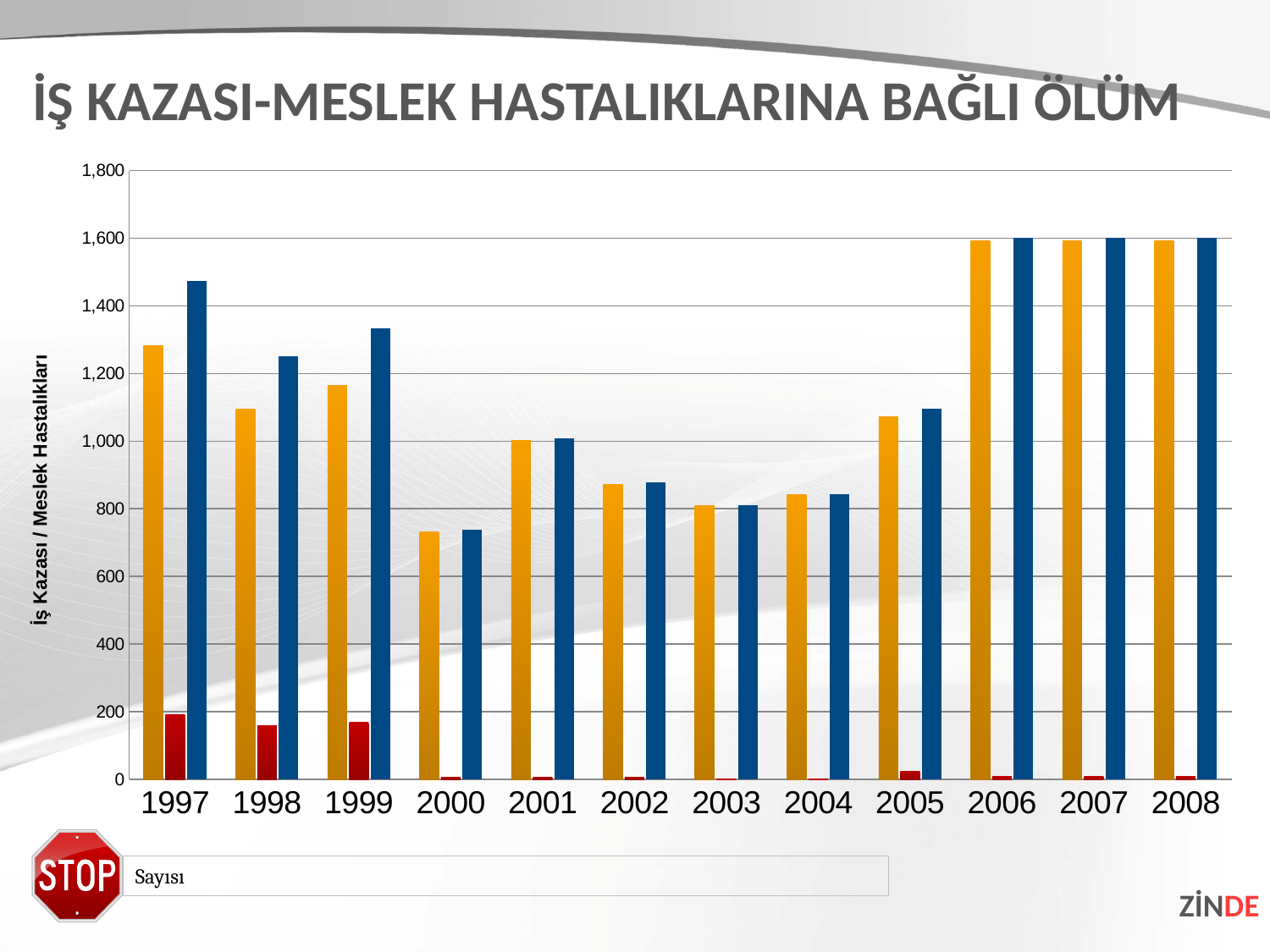
Which year has the larger blue bar, 1997 or 1998? 1997 Is the blue bar for 1997 greater or less than 1,400? greater What kind of chart is shown on the slide? bar chart What is the title of the y axis of the chart? İş Kazası / Meslek Hastalıkları In which year is the orange bar the lowest? 2000 How many years are shown on the x axis of the chart? 12 Is the blue bar for 2006 greater or less than 1,400? greater Do the orange bars rise or fall from 2003 to 2006? rise In which year is the red bar the highest? 1997 Is the orange bar for 2000 greater or less than 800? less